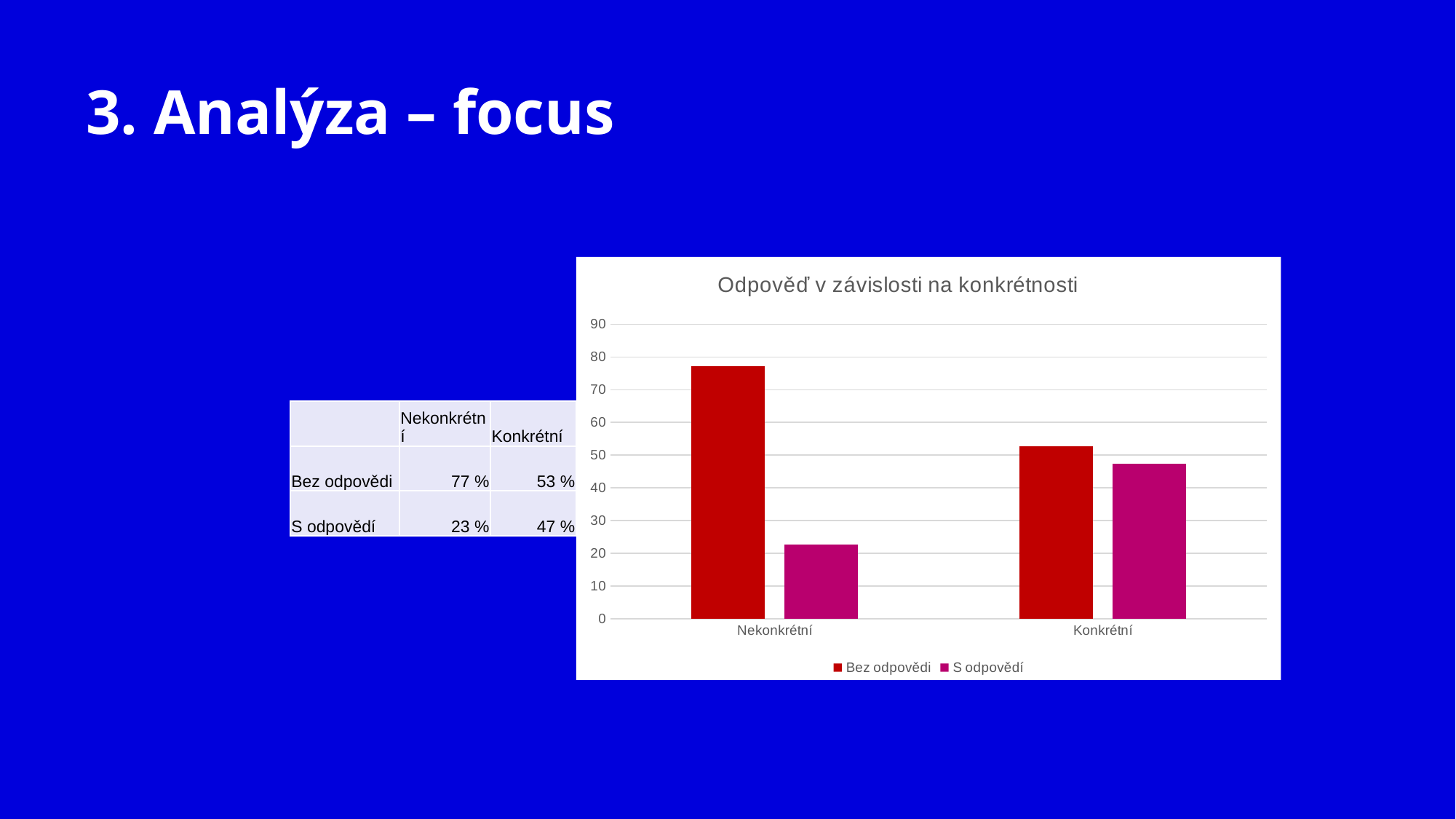
According to the table on the slide, what is the value of S odpovědí for Konkrétní? 47 % Is the Bez odpovědi bar for Nekonkrétní greater or less than 70? greater Using the table values, what is the difference between Bez odpovědi and S odpovědí for Nekonkrétní? 54 % Which series is shown in red in the chart? Bez odpovědi Is the S odpovědí bar for Nekonkrétní greater or less than 30? less According to the table on the slide, what is the value of S odpovědí for Nekonkrétní? 23 % According to the table on the slide, what is the value of Bez odpovědi for Nekonkrétní? 77 % Which category has the taller Bez odpovědi bar, Nekonkrétní or Konkrétní? Nekonkrétní How many series does the chart legend list? 2 How many categories are shown on the x axis of the chart? 2 What is the title of the chart? Odpověď v závislosti na konkrétnosti What kind of chart is shown on the slide? bar chart